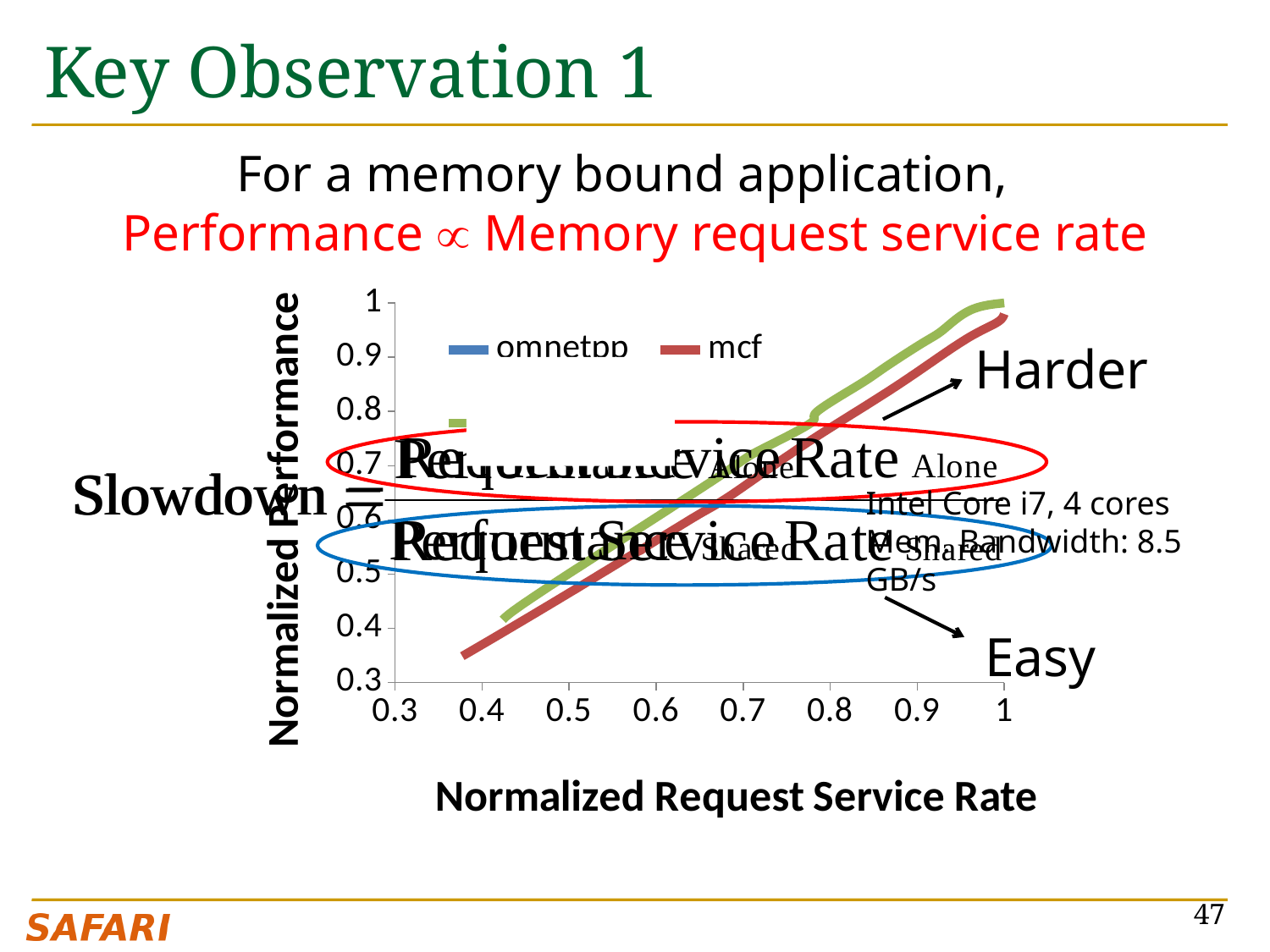
What is the lowest value shown on the y axis of the chart? 0.3 Is the normalized performance of mcf at a normalized request service rate of 0.6 greater or less than 0.7? less What kind of chart is shown on the slide? line chart Do the plotted values rise or fall as the normalized request service rate increases along the x axis? rise Is the normalized performance of mcf at a normalized request service rate of 1 greater or less than 0.9? greater What is the title of the x axis of the chart? Normalized Request Service Rate What is the highest value shown on the x axis of the chart? 1 Is the lowest plotted normalized performance value for mcf greater or less than 0.4? less